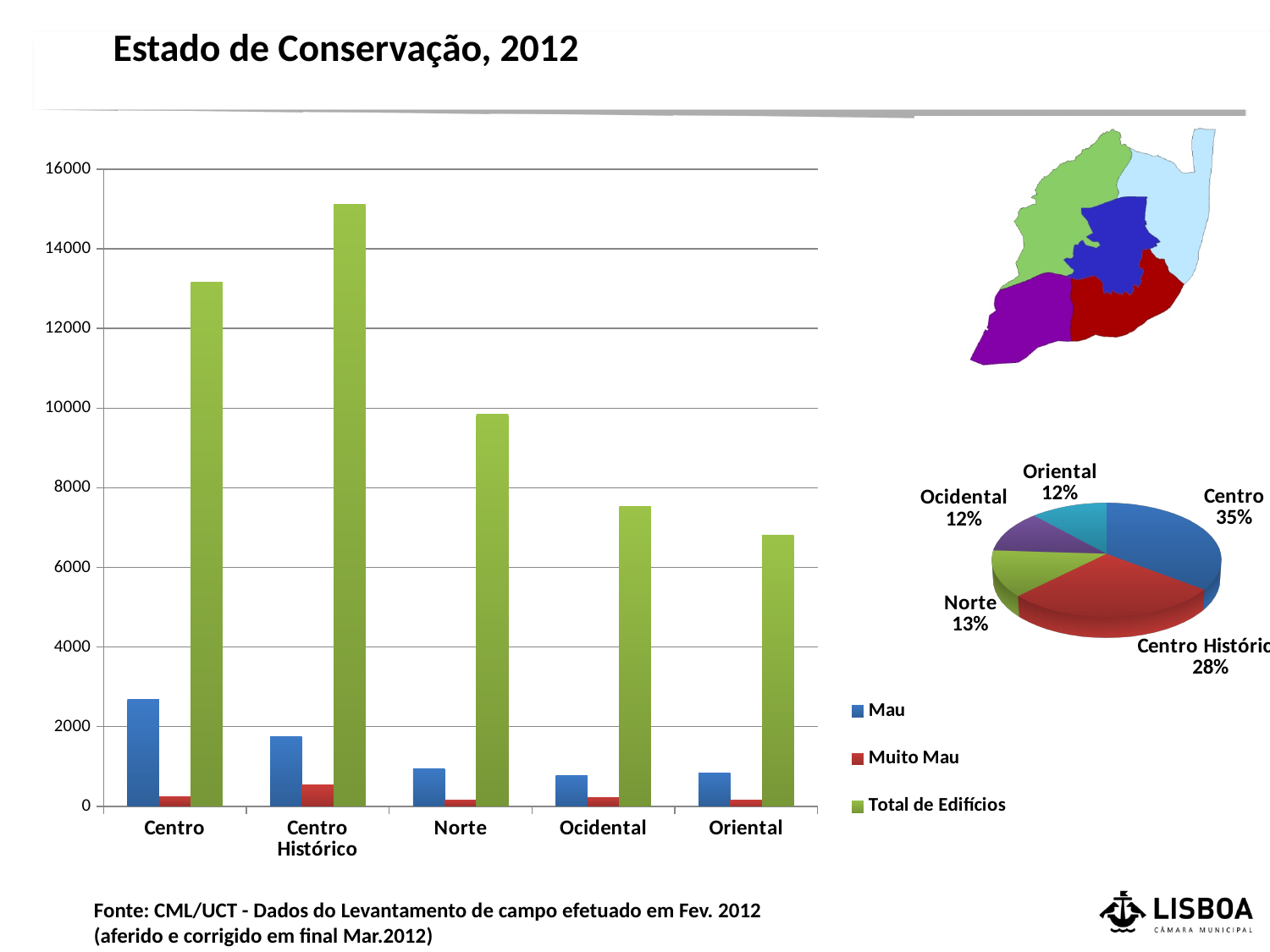
In the bar chart on the left, is the Mau value for Centro greater or less than 2000? greater In the bar chart on the left, how many series does the legend list? 3 In the bar chart on the left, is the Total de Edifícios value for Centro Histórico greater or less than 14000? greater What kind of chart is the chart on the left of the slide? bar chart In the pie chart on the right, what share does Centro have? 35% In the bar chart on the left, which is larger: the Mau value for Centro or the Mau value for Centro Histórico? Centro What kind of chart is the chart on the right of the slide showing percentages? pie chart In the bar chart on the left, how many categories are shown on the x axis? 5 In the pie chart on the right, which slice is the largest? Centro In the pie chart on the right, what is the difference in percentage points between the Centro and Centro Histórico slices? 7 In the bar chart on the left, which category has the lowest value for Total de Edifícios? Oriental In the bar chart on the left, which category has the highest value for Total de Edifícios? Centro Histórico